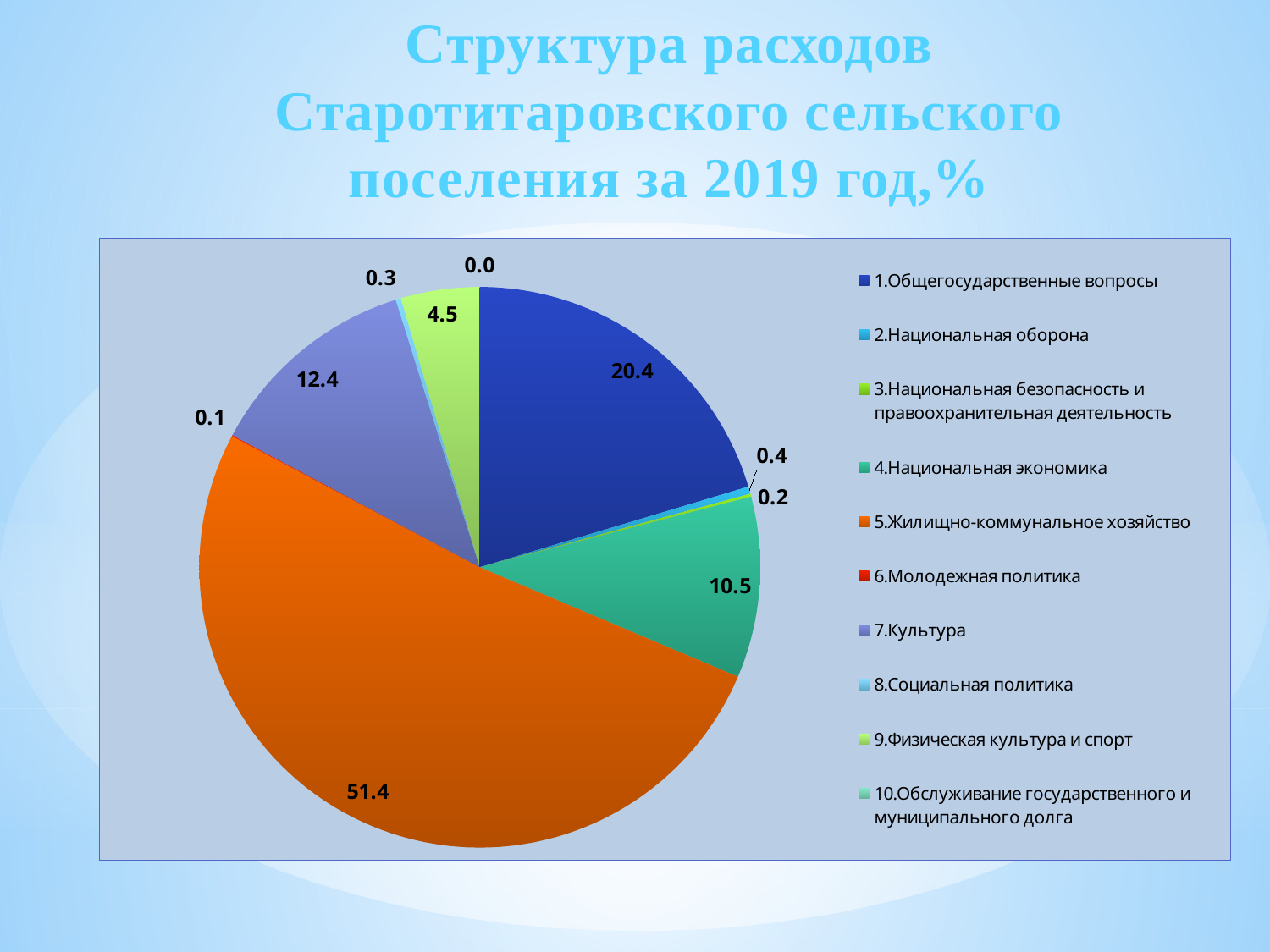
What is the difference between the values for 5.Жилищно-коммунальное хозяйство and 1.Общегосударственные вопросы? 31.0 What is the title of the chart? Структура расходов Старотитаровского сельского поселения за 2019 год,% What is the value for 5.Жилищно-коммунальное хозяйство? 51.4 What is the value for 1.Общегосударственные вопросы? 20.4 Which is larger, the value for 7.Культура or the value for 4.Национальная экономика? 7.Культура How many categories does the legend list? 10 What is the value for 4.Национальная экономика? 10.5 What type of chart is shown on the slide? pie chart Which category has the smallest share of the pie? 10.Обслуживание государственного и муниципального долга Which category has the largest share of the pie? 5.Жилищно-коммунальное хозяйство What is the value for 7.Культура? 12.4 What is the value for 9.Физическая культура и спорт? 4.5